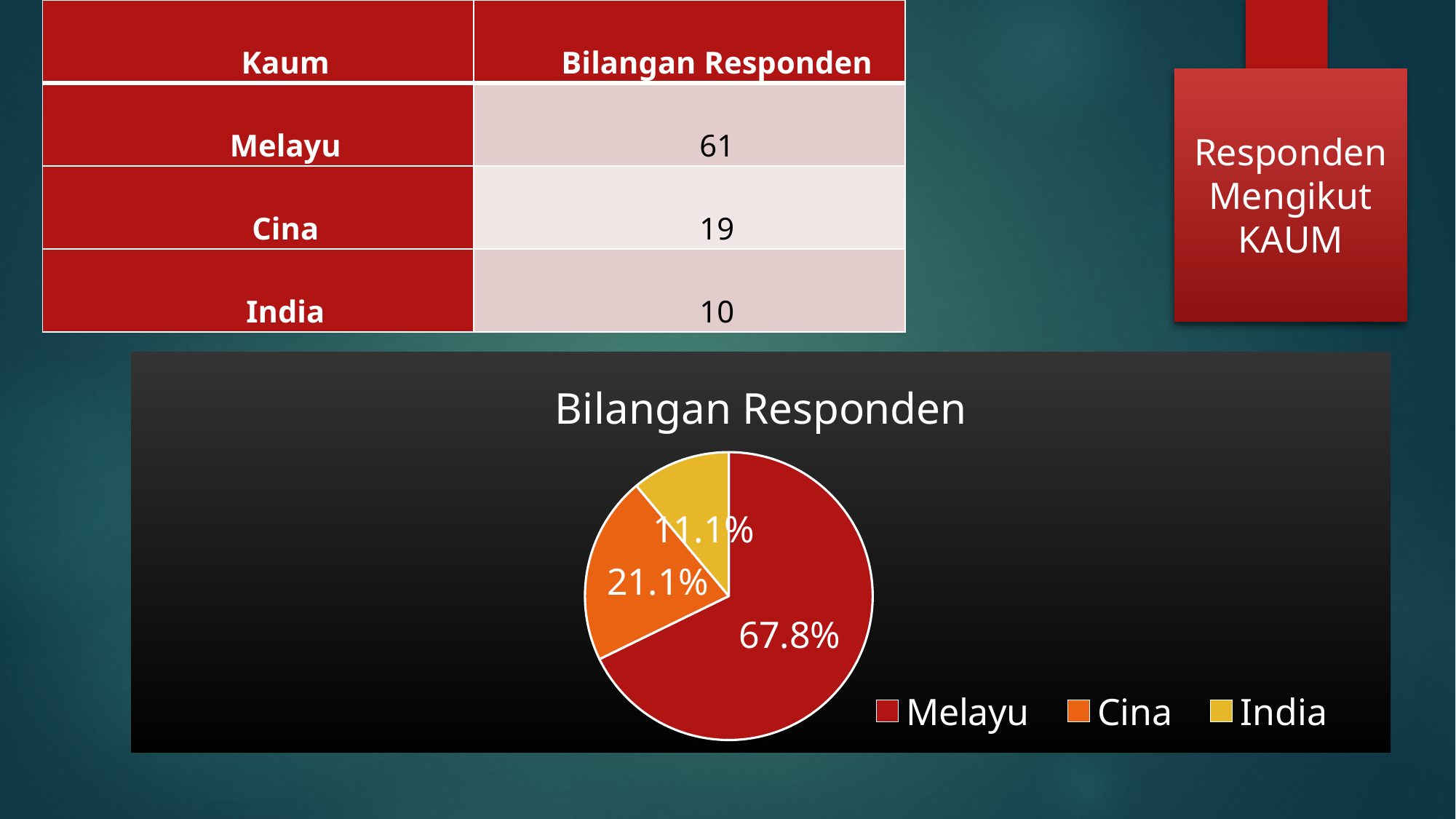
Which category has the largest slice of the pie? Melayu How many categories are shown in the pie chart? 3 Is the share for Melayu greater or less than 50%? greater What share of the pie does Cina represent? 21.1% What type of chart is shown on the slide? pie chart Which category has the smallest slice of the pie? India Which slice is larger, Cina or India? Cina What share of the pie does Melayu represent? 67.8% What is the title of the chart? Bilangan Responden What share of the pie does India represent? 11.1% Which category is shown in orange in the pie chart? Cina What is the difference in percentage points between the Melayu and Cina slices? 46.7